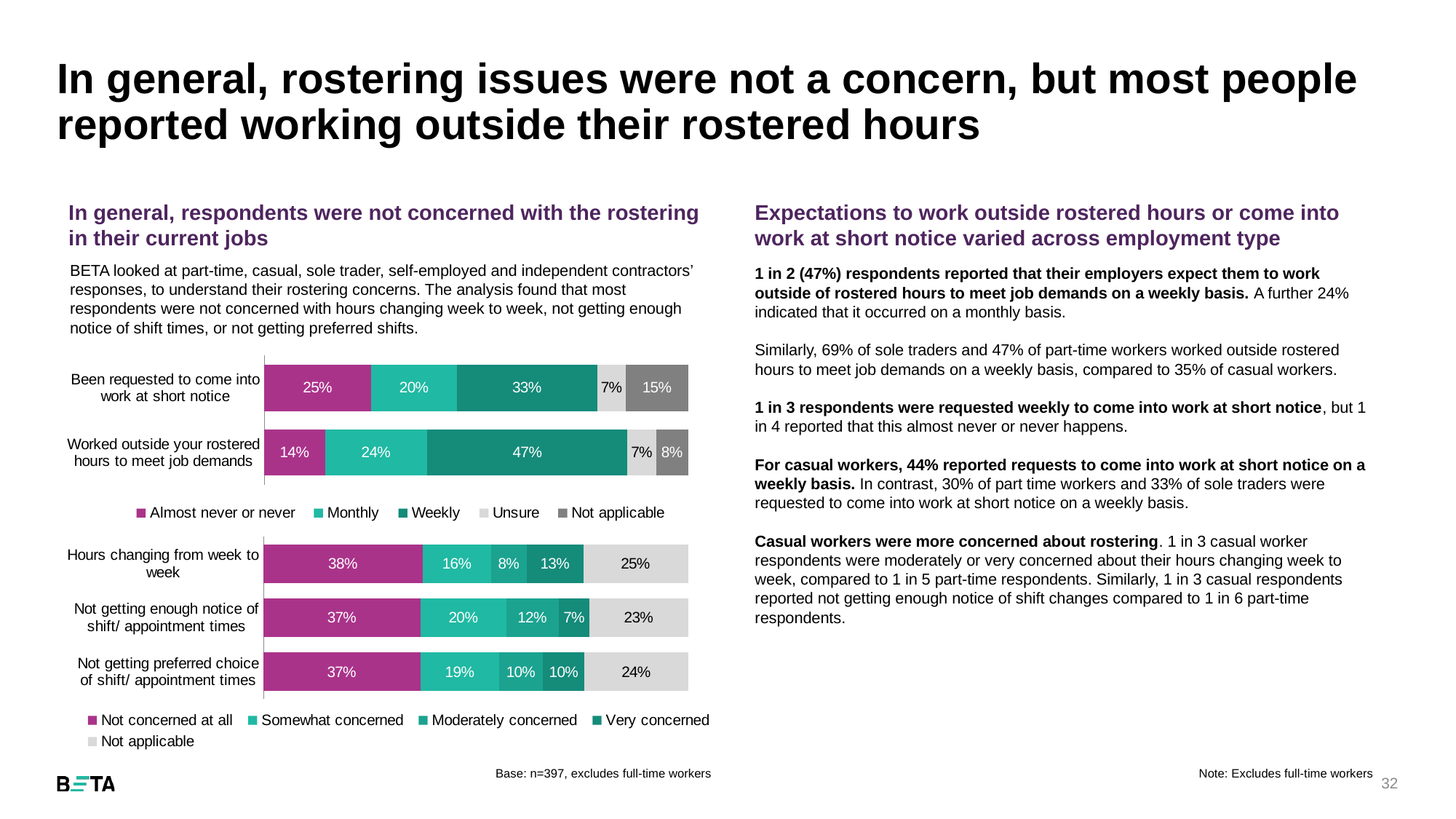
In the lower chart, what is the 'Moderately concerned' value for 'Not getting enough notice of shift/ appointment times'? 12% In the upper chart, what percentage of respondents said they worked outside their rostered hours to meet job demands on a weekly basis? 47% How many categories are plotted in the lower chart? 3 In the lower chart, which is larger: the 'Very concerned' value for 'Hours changing from week to week' or for 'Not getting enough notice of shift/ appointment times'? Hours changing from week to week In the upper chart, what is the difference between the 'Weekly' values for 'Worked outside your rostered hours to meet job demands' and 'Been requested to come into work at short notice'? 14 percentage points In the upper chart, which series is shown in dark grey? Not applicable In the upper chart, what is the 'Almost never or never' value for 'Been requested to come into work at short notice'? 25% In the lower chart, which category has the highest 'Not concerned at all' value? Hours changing from week to week What kind of chart is the lower chart? Stacked bar chart In the lower chart, what is the 'Not applicable' value for 'Not getting preferred choice of shift/ appointment times'? 24% How many series does the legend of the upper chart list? 5 In the upper chart, what is the total of all segments in the 'Been requested to come into work at short notice' bar? 100%